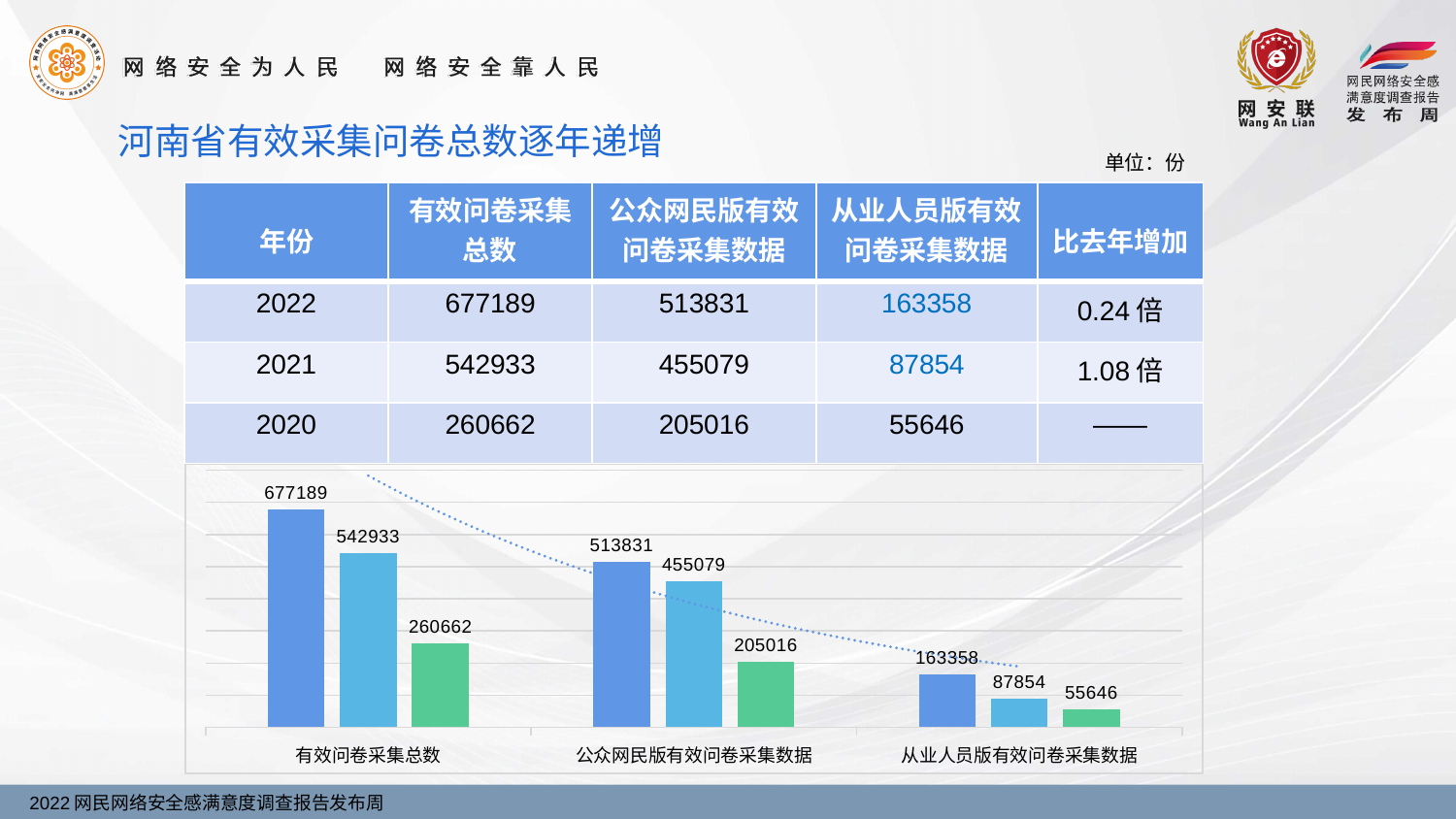
Within each group of the bar chart, do the bars rise or fall from left to right? fall What is the title of the slide above the chart? 河南省有效采集问卷总数逐年递增 Which category in the bar chart has the lowest bar overall? 从业人员版有效问卷采集数据 In the bar chart, what is the difference between the dark blue bar and the green bar in the 从业人员版有效问卷采集数据 group? 107712 In the bar chart, what is the difference between the dark blue bar and the light blue bar in the 有效问卷采集总数 group? 134256 In the bar chart, which is larger: the green bar in the 有效问卷采集总数 group or the dark blue bar in the 从业人员版有效问卷采集数据 group? the green bar in the 有效问卷采集总数 group In the bar chart, what is the value of the green bar in the 公众网民版有效问卷采集数据 group? 205016 What type of chart is shown on the slide? bar chart In the bar chart, what is the value of the tallest bar in the 有效问卷采集总数 group? 677189 How many categories are shown along the x axis of the bar chart? 3 In the bar chart, what is the value of the light blue bar in the 从业人员版有效问卷采集数据 group? 87854 Which category in the bar chart has the highest bar overall? 有效问卷采集总数